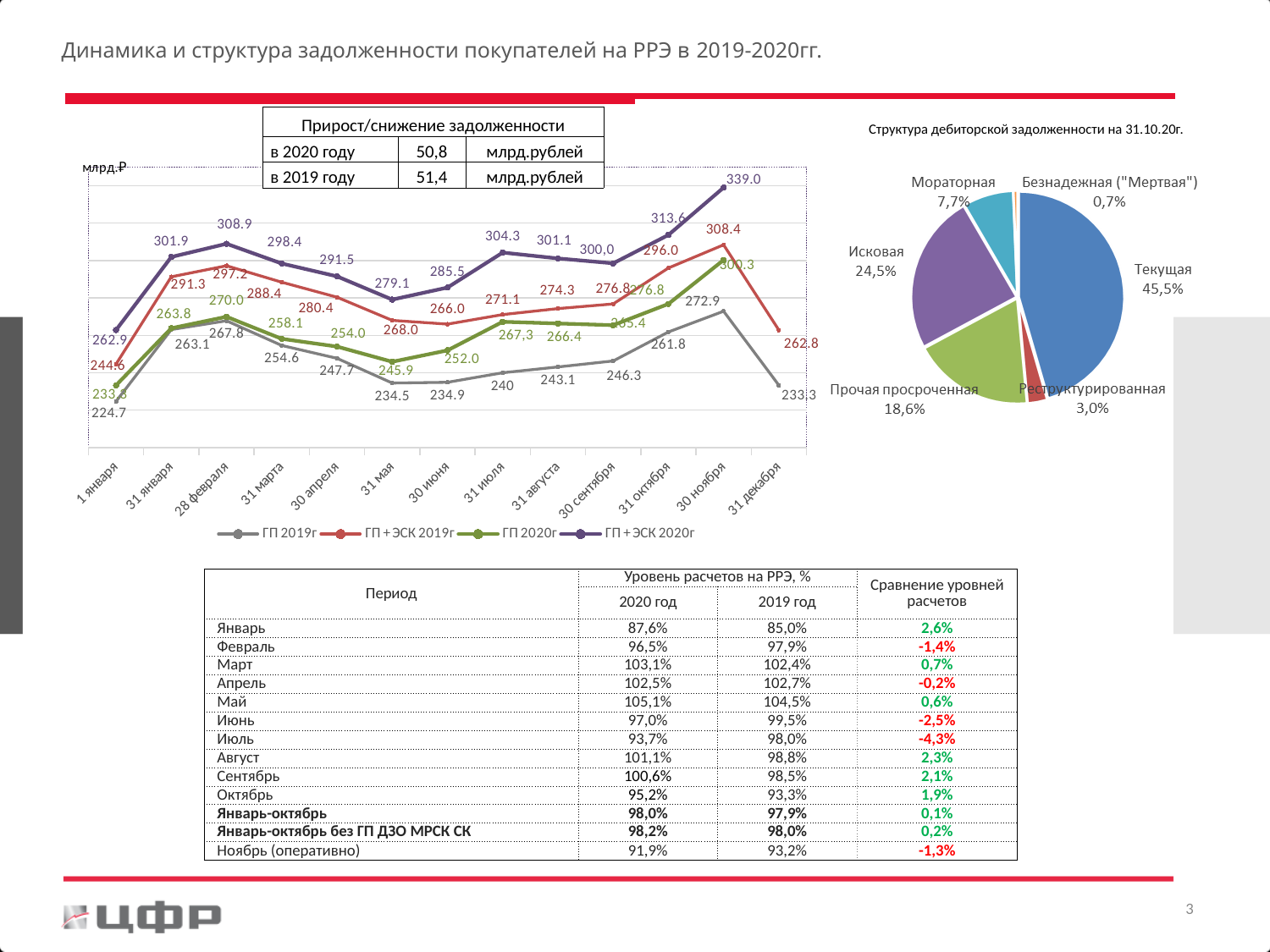
On the line chart, what is the value of the ГП 2019г series on 1 января? 224.7 On the line chart, what is the value of the ГП + ЭСК 2020г series on 30 ноября? 339.0 How many slices does the pie chart 'Структура дебиторской задолженности на 31.10.20г.' have? 6 What kind of chart is the chart on the left of the slide? line chart In the pie chart 'Структура дебиторской задолженности на 31.10.20г.', what share does Исковая have? 24,5% On the line chart, does the ГП + ЭСК 2020г series rise or fall from 30 сентября to 30 ноября? rise On the line chart, which is larger on 31 декабря: ГП + ЭСК 2019г or ГП 2019г? ГП + ЭСК 2019г In the pie chart 'Структура дебиторской задолженности на 31.10.20г.', which category has the largest share? Текущая How many series does the legend of the line chart list? 4 On the line chart, what is the difference between the ГП + ЭСК 2020г and ГП + ЭСК 2019г values on 30 ноября? 30.6 On the line chart, what is the value of the ГП + ЭСК 2019г series on 31 декабря? 262.8 On the line chart, at which date does the ГП + ЭСК 2020г series reach its highest value? 30 ноября